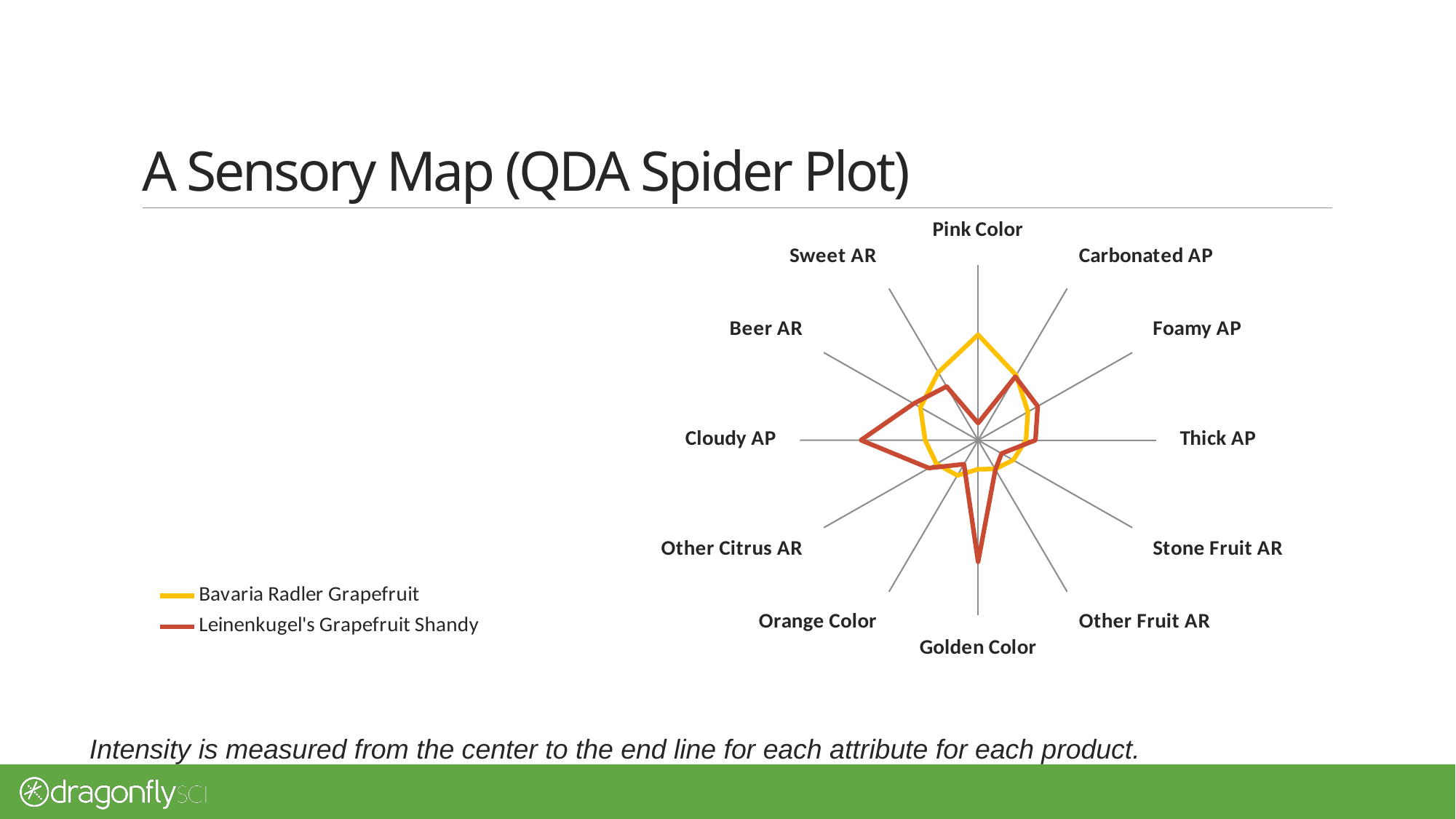
On which attribute does Leinenkugel's Grapefruit Shandy have its lowest intensity? Pink Color How many series does the legend list? 2 Which product has the higher intensity for Pink Color? Bavaria Radler Grapefruit What kind of chart is shown on the slide? Radar (spider) chart On which attribute does Bavaria Radler Grapefruit have its highest intensity? Pink Color Which product has the higher intensity for Cloudy AP? Leinenkugel's Grapefruit Shandy How many attributes (spokes) are plotted on the spider plot? 12 Which product has the higher intensity for Foamy AP? Leinenkugel's Grapefruit Shandy Which colour represents Leinenkugel's Grapefruit Shandy in the legend? Red